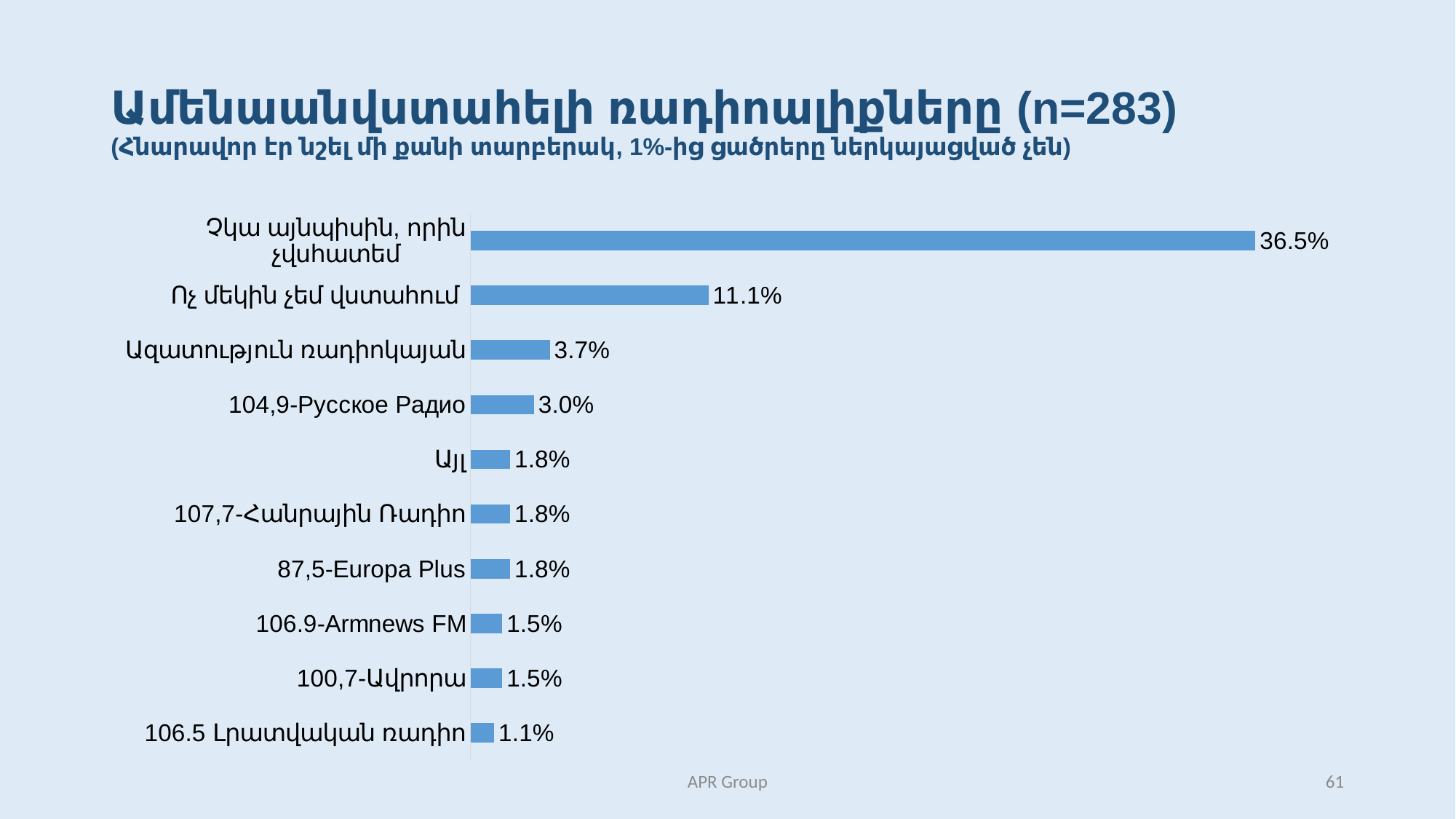
What is the difference between the values for "Չկա այնպիսին, որին չվկահատեմ" and "Ոչ մեկին չեմ վստահում"? 25.4% Which category has the highest value? Չկա այնպիսին, որին չվսհատեմ What is the value for "106.9-Armnews FM"? 1.5% Which category has the lowest value? 106.5 Լրատվական ռադիո What is the value for "Ազատություն ռադիոկայան"? 3.7% What kind of chart is shown on the slide? Bar chart What sample size (n) is given in the chart title? n=283 What is the value for "87,5-Europa Plus"? 1.8% What is the difference between the values for "104,9-Русское Радио" and "106.5 Լրատվական ռադիո"? 1.9% Which is larger, the value for "Ազատություն ռադիոկայան" or for "104,9-Русское Радио"? Ազատություն ռադիոկայան What is the value for "104,9-Русское Радио"? 3.0% How many categories are shown in the chart? 10